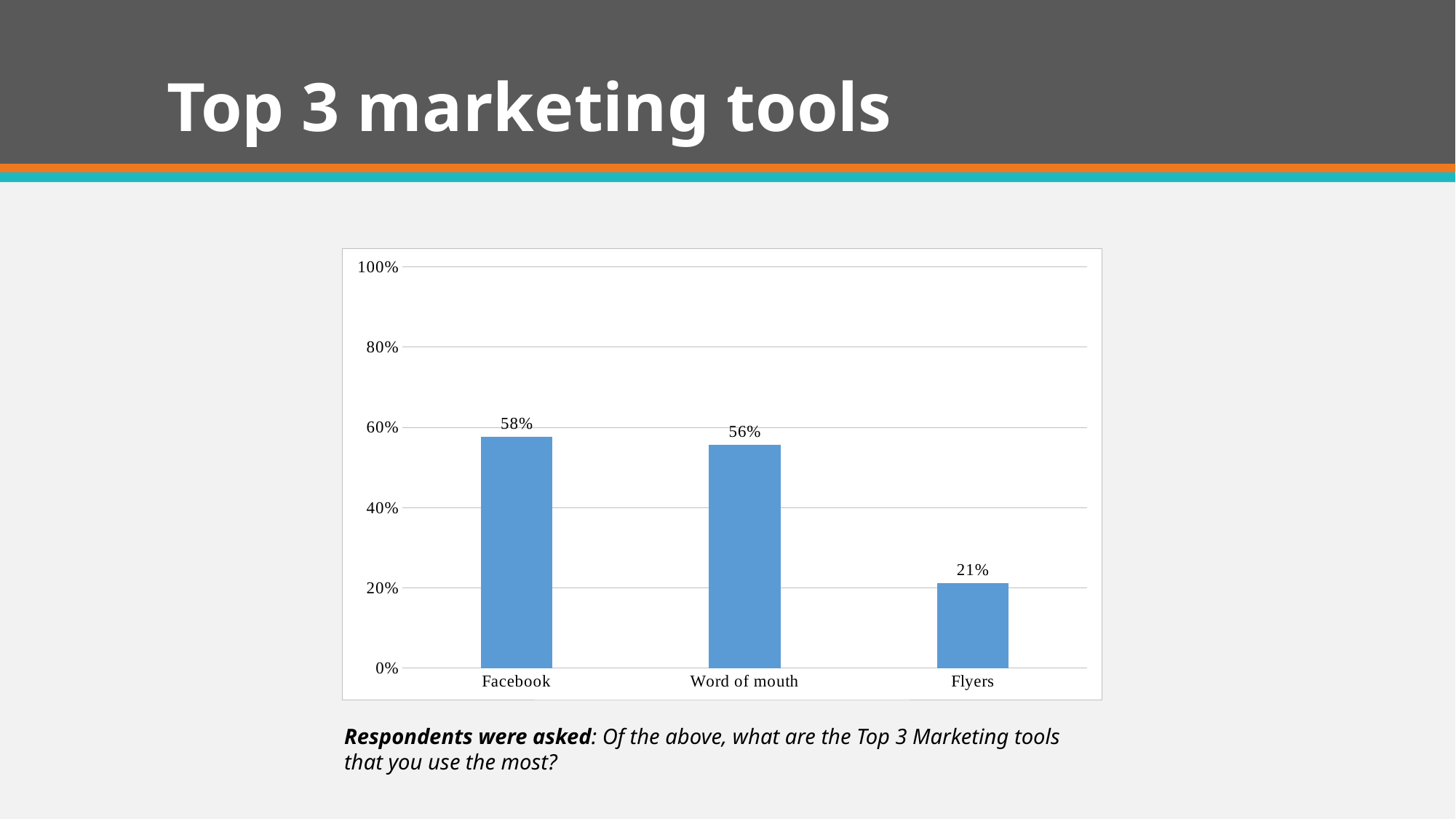
What is the value for Facebook? 58% What is the title of the slide? Top 3 marketing tools Which marketing tool has the highest value? Facebook How many categories are shown in the chart? 3 Which marketing tool has the lowest value? Flyers What kind of chart is shown on the slide? Bar chart What is the value for Word of mouth? 56% What is the difference between the values for Word of mouth and Flyers? 35% What is the difference between the values for Facebook and Flyers? 37% Which is larger, the value for Word of mouth or the value for Flyers? Word of mouth What is the value for Flyers? 21% Is the value for Flyers greater or less than 40%? less